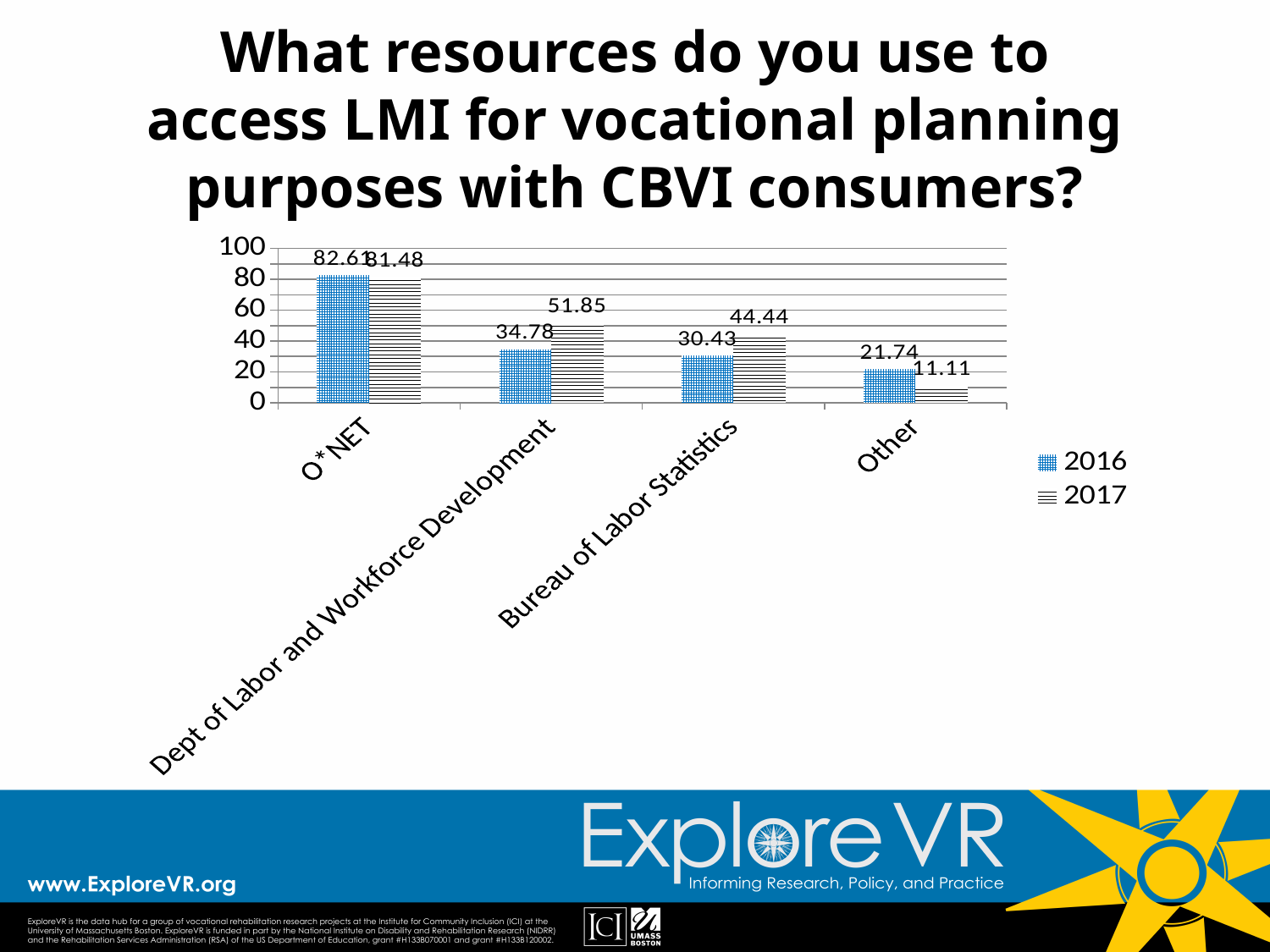
How many series does the legend list? 2 What is the difference between the 2017 and 2016 values for Dept of Labor and Workforce Development? 17.07 Which category has the lowest 2016 value? Other Which category has the highest 2017 value? O*NET How many categories are shown on the x axis? 4 What is the 2016 value for Dept of Labor and Workforce Development? 34.78 Is the 2016 value for O*NET greater or less than 60? greater What is the difference between the 2017 and 2016 values for Bureau of Labor Statistics? 14.01 What is the 2016 value for Bureau of Labor Statistics? 30.43 For Other, which year has the larger value, 2016 or 2017? 2016 What is the 2017 value for Other? 11.11 What is the 2017 value for Dept of Labor and Workforce Development? 51.85